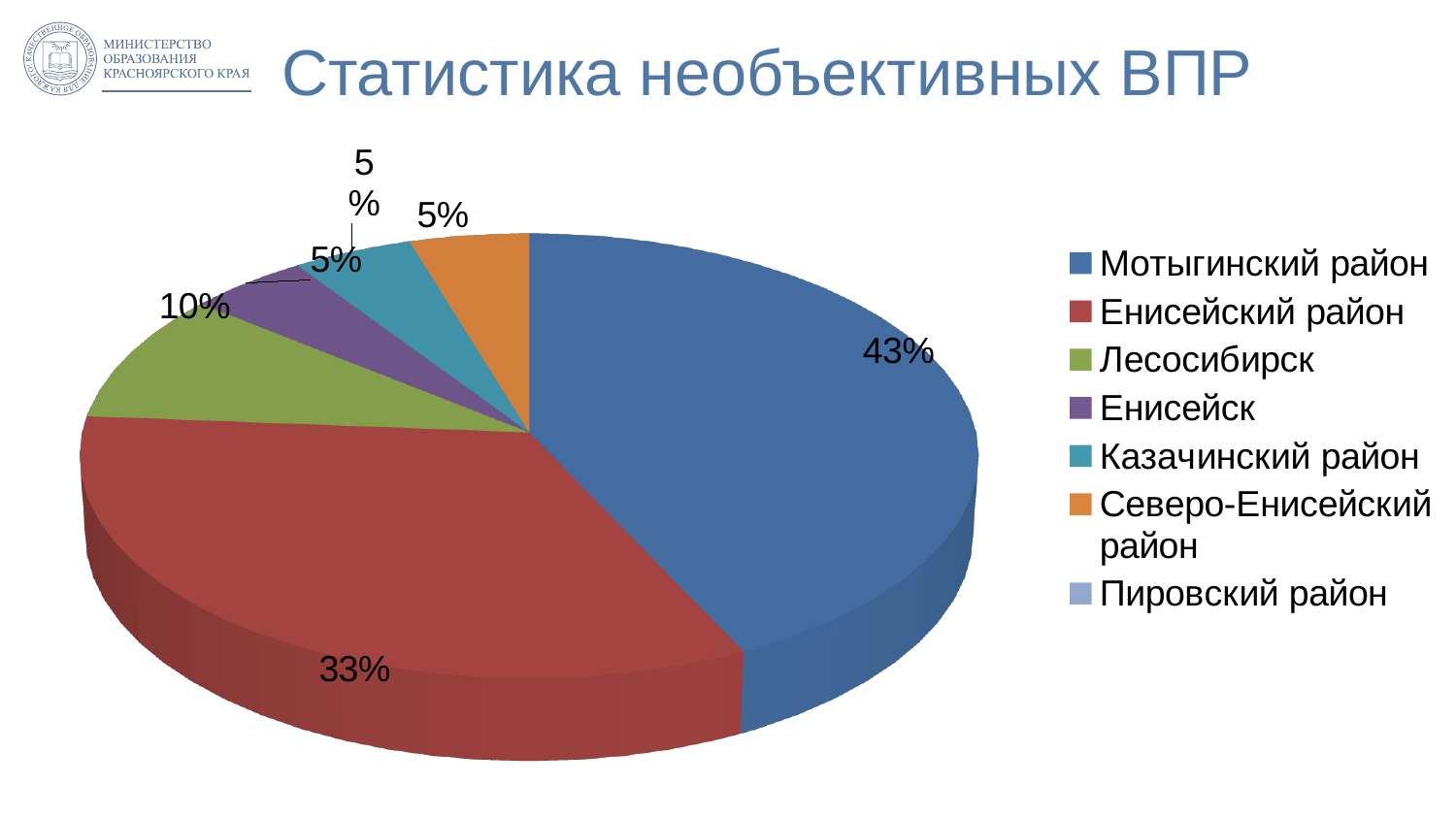
What is the value for Лесосибирск? 10% Which is larger, the value for Лесосибирск or the value for Енисейск? Лесосибирск What is the value for Мотыгинский район? 43% Which category has the largest slice of the pie? Мотыгинский район How many entries does the legend list? 7 What share of the pie do Мотыгинский район and Енисейский район take together? 76% What is the value for Казачинский район? 5% Which is larger, the value for Енисейский район or the value for Мотыгинский район? Мотыгинский район What is the value for Енисейский район? 33% What is the title of the slide? Статистика необъективных ВПР What kind of chart is shown on the slide? pie chart What is the difference between the values for Мотыгинский район and Енисейский район? 10 percentage points